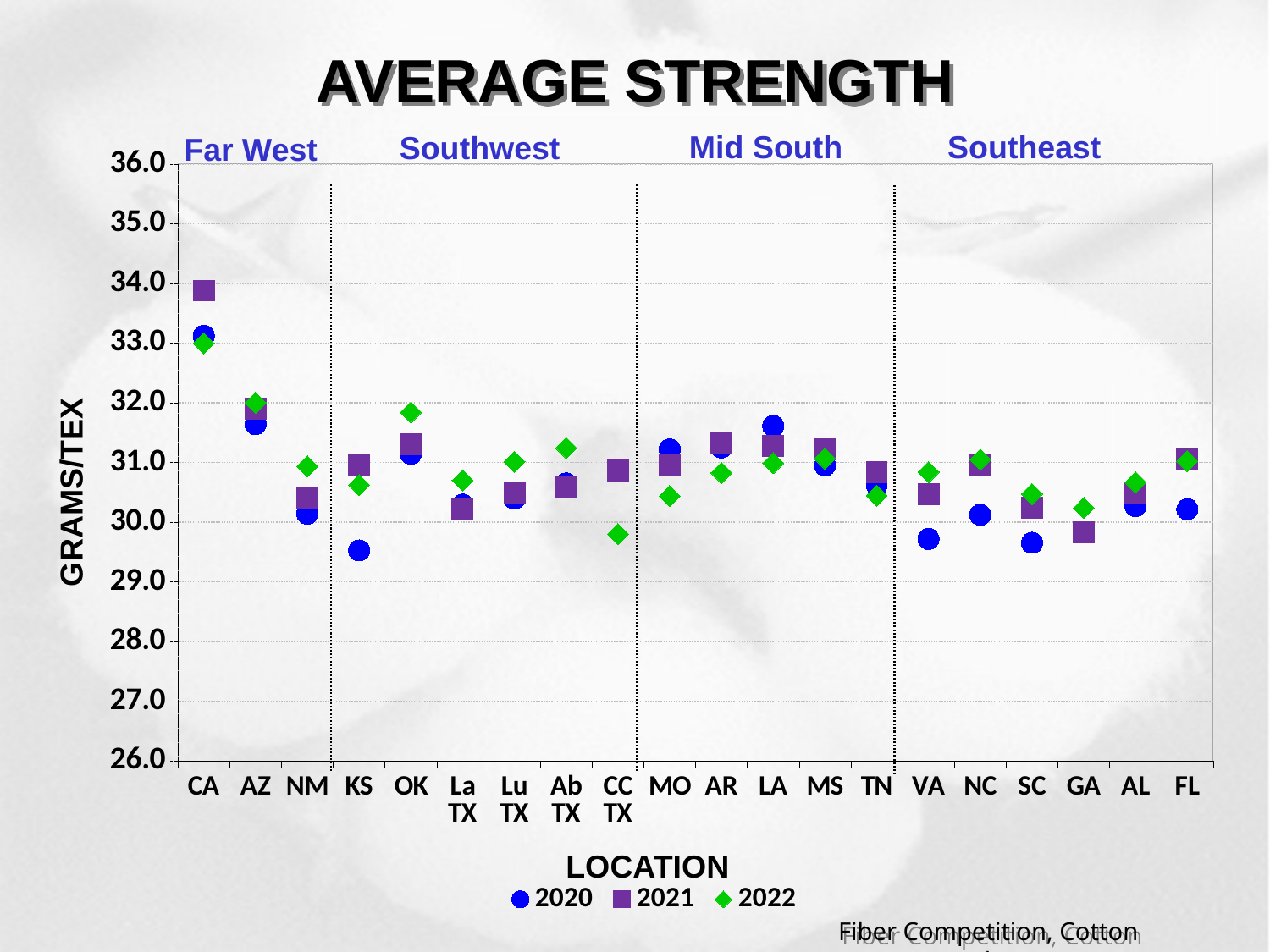
Is the 2022 value for OK greater or less than 31.0? greater How many locations are plotted along the x axis? 20 Which location has the highest 2022 value? CA Which location has the lowest 2022 value? CC TX For KS, which is larger: the 2020 value or the 2021 value? 2021 Is the 2020 value for KS greater or less than 30.0? less Which location has the highest 2021 value? CA How many series does the legend list? 3 Is the 2021 value for CA greater or less than 33.0? greater What kind of chart is shown on the slide? Scatter chart Which location has the lowest 2021 value? GA What is the title of the y axis? GRAMS/TEX